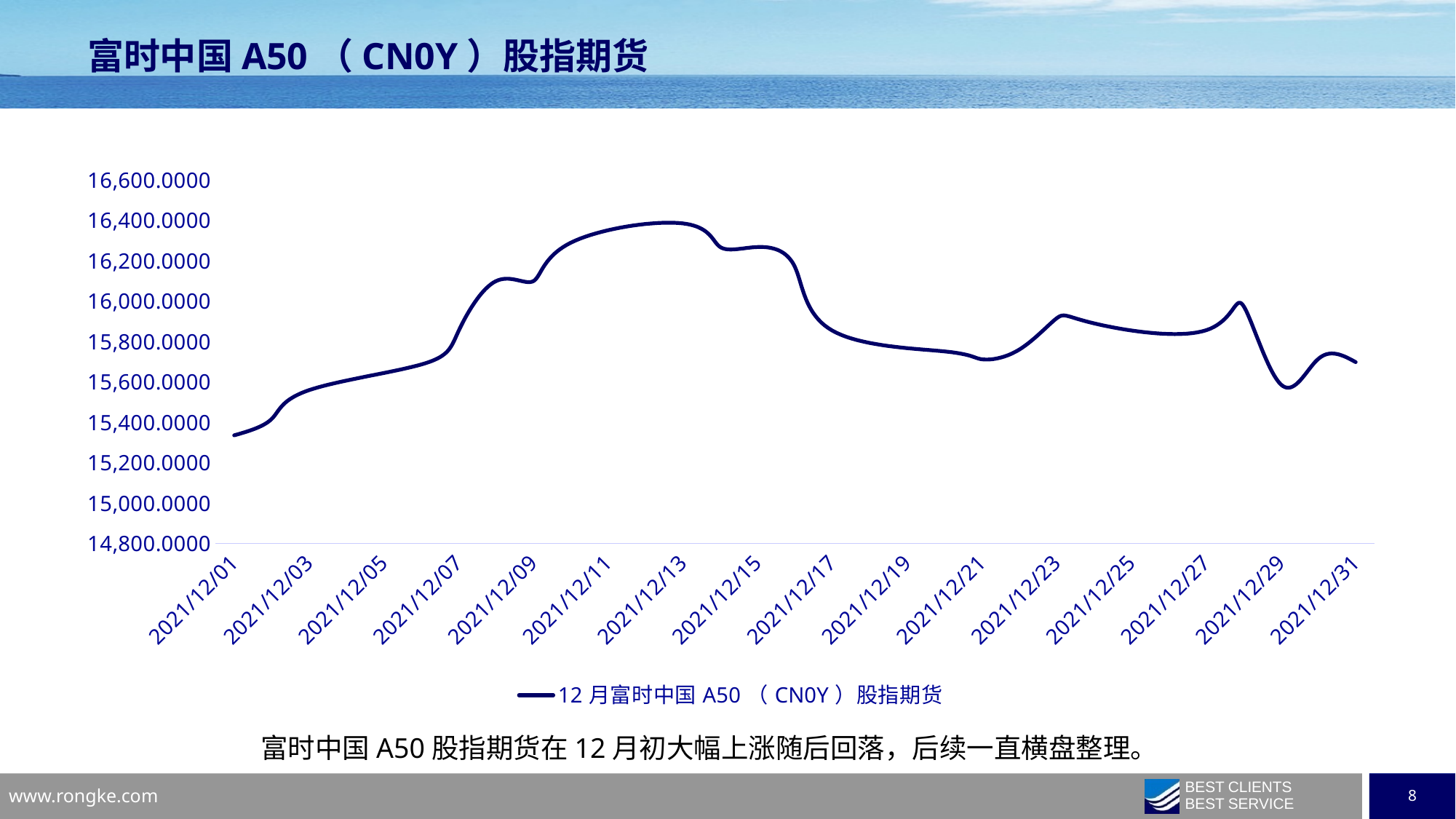
How many series does the legend list? 1 Which is larger, the value at 2021/12/13 or the value at 2021/12/23? 2021/12/13 Is the value for 2021/12/29 greater or less than 15,800? less What is the legend entry for the plotted line? 12 月富时中国 A50 （CN0Y） 股指期货 Is the value for 2021/12/01 greater or less than 15,600? less Is the value for 2021/12/13 greater or less than 16,200? greater What is the title of the slide's chart? 富时中国 A50 （CN0Y） 股指期货 At which date label is the line at its lowest value? 2021/12/01 What kind of chart is shown on the slide? line chart How many date labels are shown on the x axis? 16 Does the line rise or fall between 2021/12/01 and 2021/12/13? rise Around which date label does the line reach its highest value? 2021/12/13